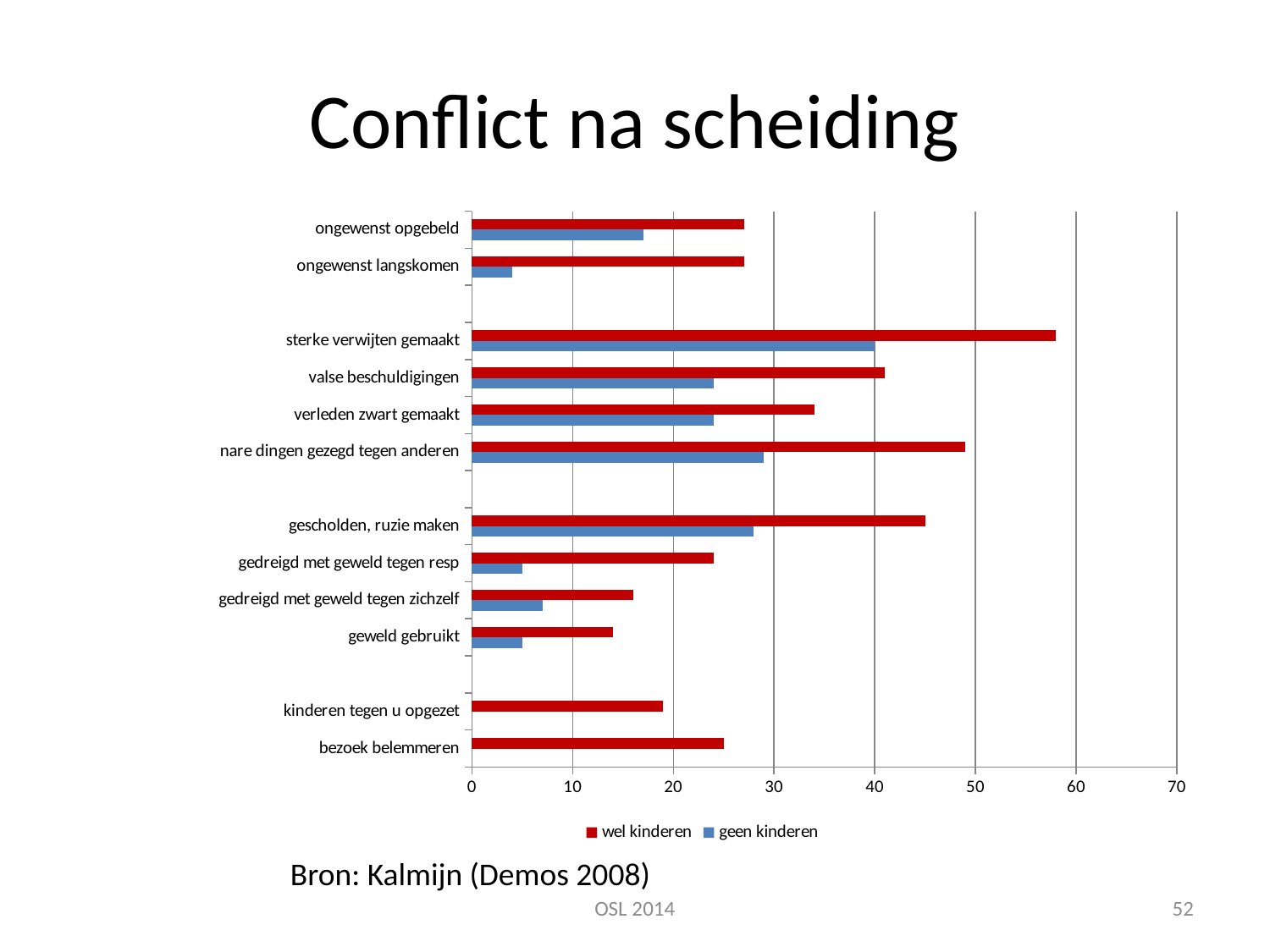
How many series does the legend list? 2 Is the 'geen kinderen' value for 'ongewenst langskomen' greater or less than 10? less What is the title of the chart? Conflict na scheiding What are the two series named in the legend? wel kinderen, geen kinderen Which category has the highest value for the 'wel kinderen' series? sterke verwijten gemaakt What kind of chart is shown on the slide? bar chart For 'ongewenst opgebeld', which series has the larger value, 'wel kinderen' or 'geen kinderen'? wel kinderen How many labeled categories are shown on the vertical axis? 12 Is the 'wel kinderen' value for 'geweld gebruikt' greater or less than 20? less Which category has the highest value for the 'geen kinderen' series? sterke verwijten gemaakt Is the 'wel kinderen' value for 'sterke verwijten gemaakt' greater or less than 50? greater